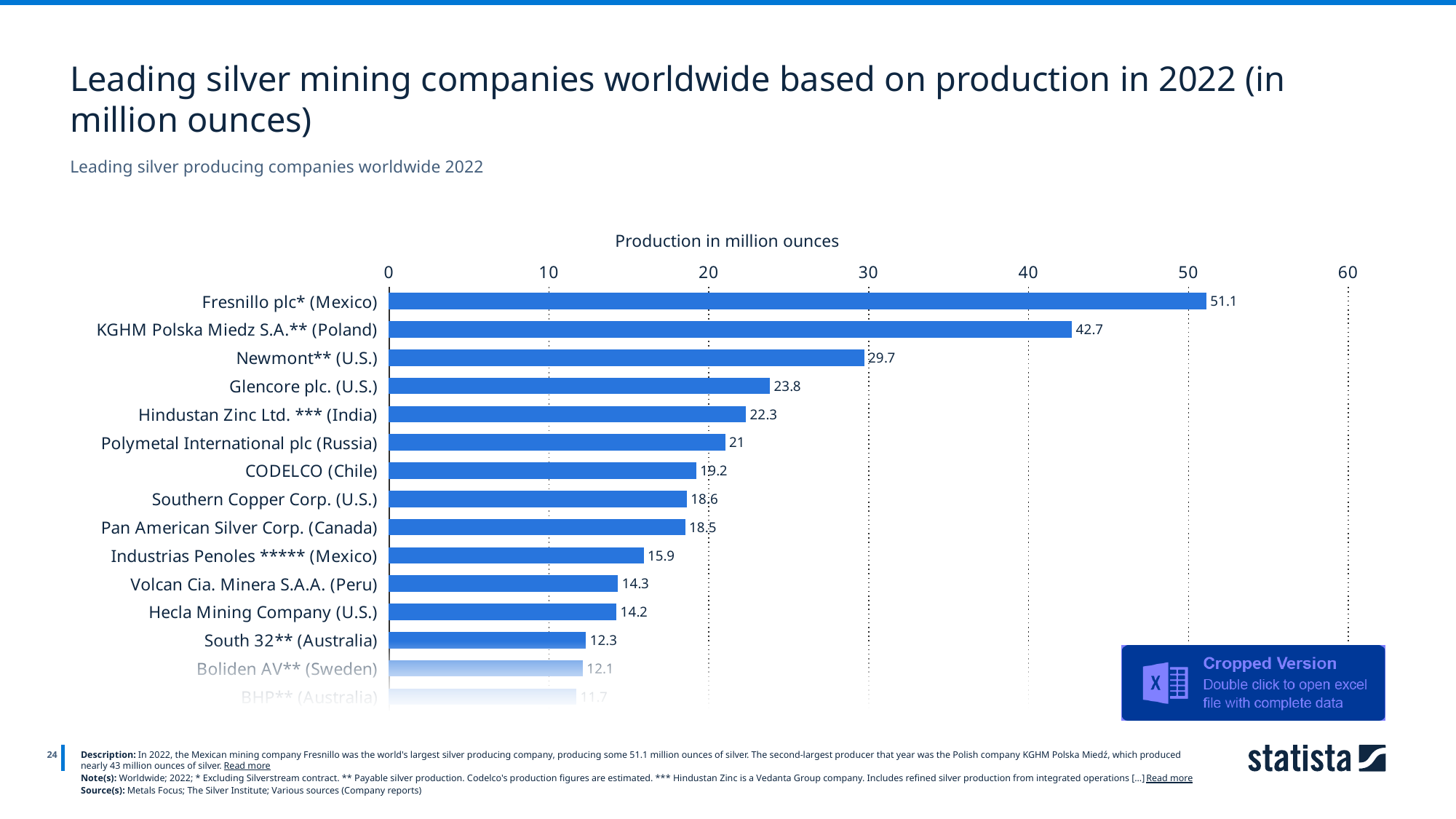
Which has a higher production value, CODELCO (Chile) or Industrias Penoles ***** (Mexico)? CODELCO (Chile) Which has a higher production value, Hindustan Zinc Ltd. *** (India) or Volcan Cia. Minera S.A.A. (Peru)? Hindustan Zinc Ltd. *** (India) What kind of chart is shown on the slide? Bar chart What is the difference in production between Fresnillo plc* (Mexico) and KGHM Polska Miedz S.A.** (Poland)? 8.4 What is the production value shown for Polymetal International plc (Russia)? 21 What is the title of the horizontal axis of the chart? Production in million ounces Is the value for Newmont** (U.S.) greater or less than 30? less What is the difference in production between Newmont** (U.S.) and Glencore plc. (U.S.)? 5.9 What was the silver production of Fresnillo plc* (Mexico) in million ounces? 51.1 What value is shown for KGHM Polska Miedz S.A.** (Poland)? 42.7 Which company has the highest silver production on the chart? Fresnillo plc* (Mexico) What value is shown for Hecla Mining Company (U.S.)? 14.2